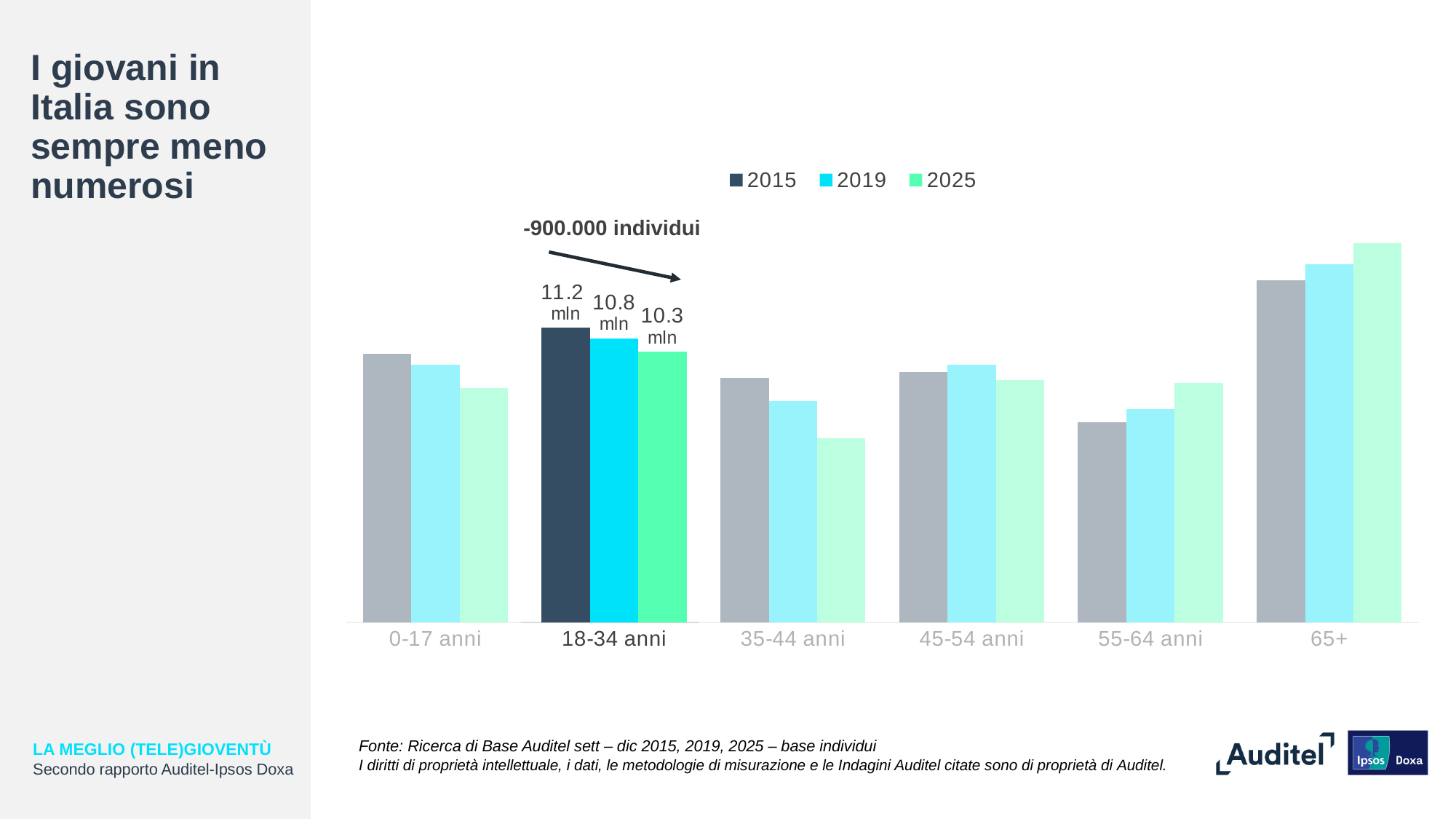
What is the value for 2019 in the 18-34 anni category? 10.8 mln What does the annotation above the 18-34 anni bars say? -900.000 individui In the 18-34 anni category, which is larger: the 2015 value or the 2019 value? 2015 What is the difference between the 2015 and 2025 values for the 18-34 anni category? 0.9 mln Which age category has the highest 2025 bar? 65+ How many age categories are shown on the x axis? 6 What kind of chart is shown on the slide? bar chart Do the values for the 18-34 anni category rise or fall from 2015 to 2025? fall How many series does the legend list? 3 What is the value for 2025 in the 18-34 anni category? 10.3 mln What is the value for 2015 in the 18-34 anni category? 11.2 mln Which age category has the lowest 2025 bar? 35-44 anni